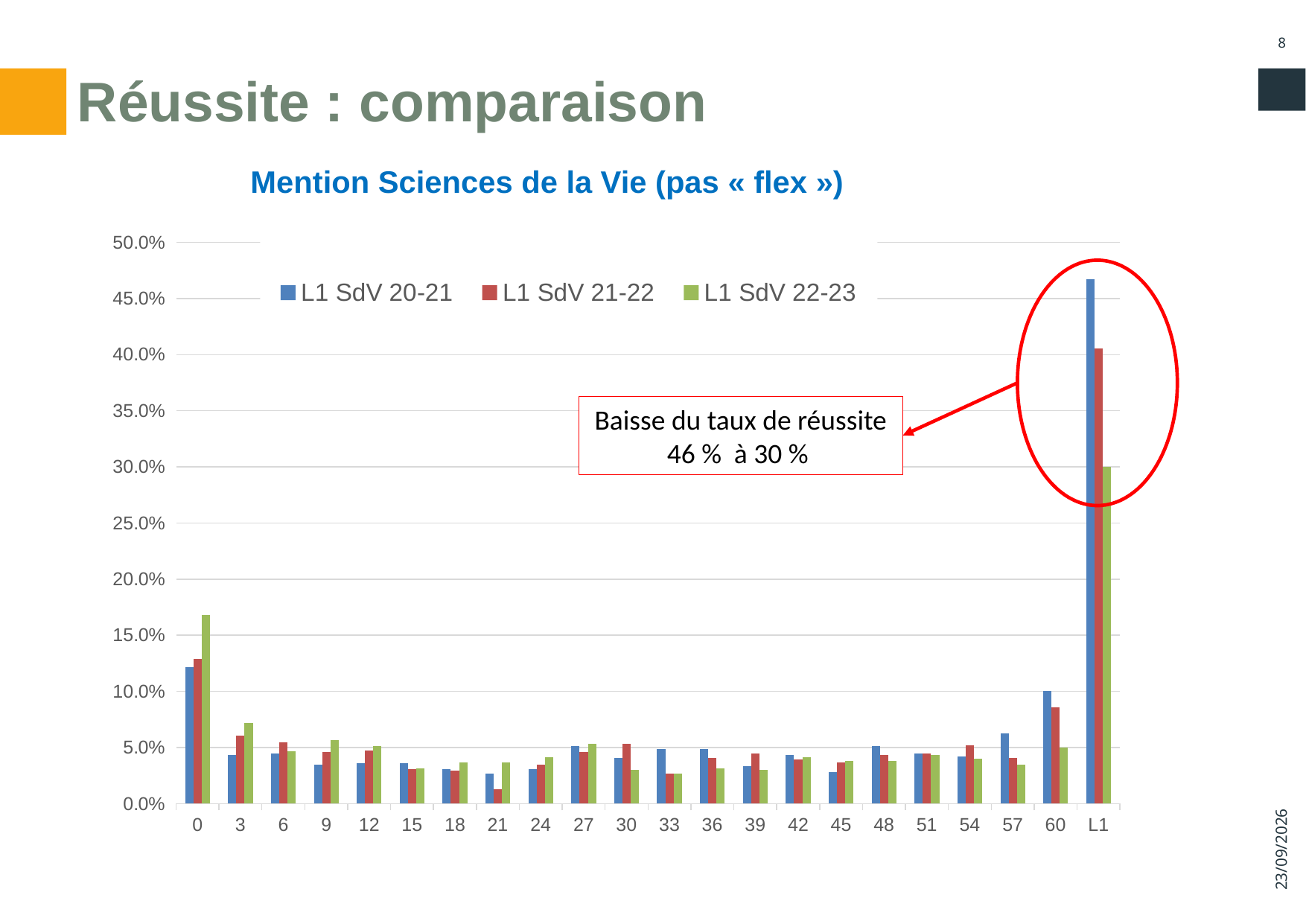
Is the value for L1 SdV 20-21 at category L1 greater or less than 45.0%? greater At category 60, which series has the larger value: L1 SdV 20-21 or L1 SdV 22-23? L1 SdV 20-21 How many categories are shown on the x axis? 22 Is the value for L1 SdV 22-23 at category L1 greater or less than 35.0%? less What is the title of the chart? Mention Sciences de la Vie (pas « flex ») What kind of chart is shown on the slide? bar chart Which series has the lowest value at category L1? L1 SdV 22-23 Which category has the highest value for the L1 SdV 20-21 series? L1 How many series does the legend list? 3 Is the value for L1 SdV 22-23 at category 0 greater or less than 15.0%? greater At category 0, which series has the larger value: L1 SdV 20-21 or L1 SdV 22-23? L1 SdV 22-23